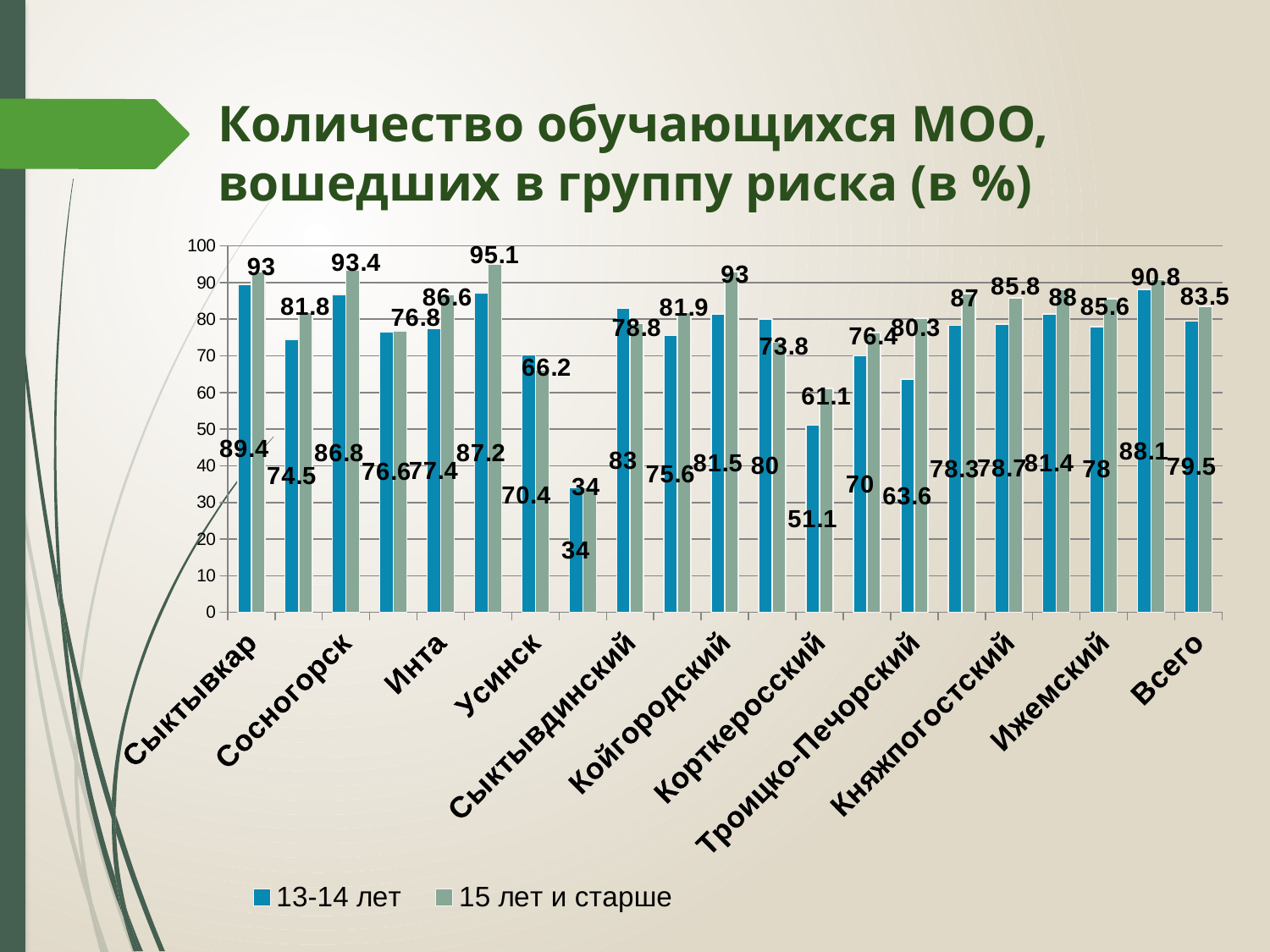
What is the value for Корткеросский in the 13-14 лет series? 51.1 What is the difference between the 15 лет и старше and 13-14 лет values for Корткеросский? 10 For Усинск, which series has the larger value: 13-14 лет or 15 лет и старше? 13-14 лет What is the value for Сыктывкар in the 15 лет и старше series? 93 What is the value for Троицко-Печорский in the 15 лет и старше series? 80.3 What is the value for Всего in the 13-14 лет series? 79.5 What is the value for Всего in the 15 лет и старше series? 83.5 What are the two series named in the legend? 13-14 лет and 15 лет и старше Is the 13-14 лет value for Корткеросский greater or less than 60? less How many series does the legend list? 2 What is the difference between the 15 лет и старше and 13-14 лет values for Всего? 4 What type of chart is shown on the slide? bar chart